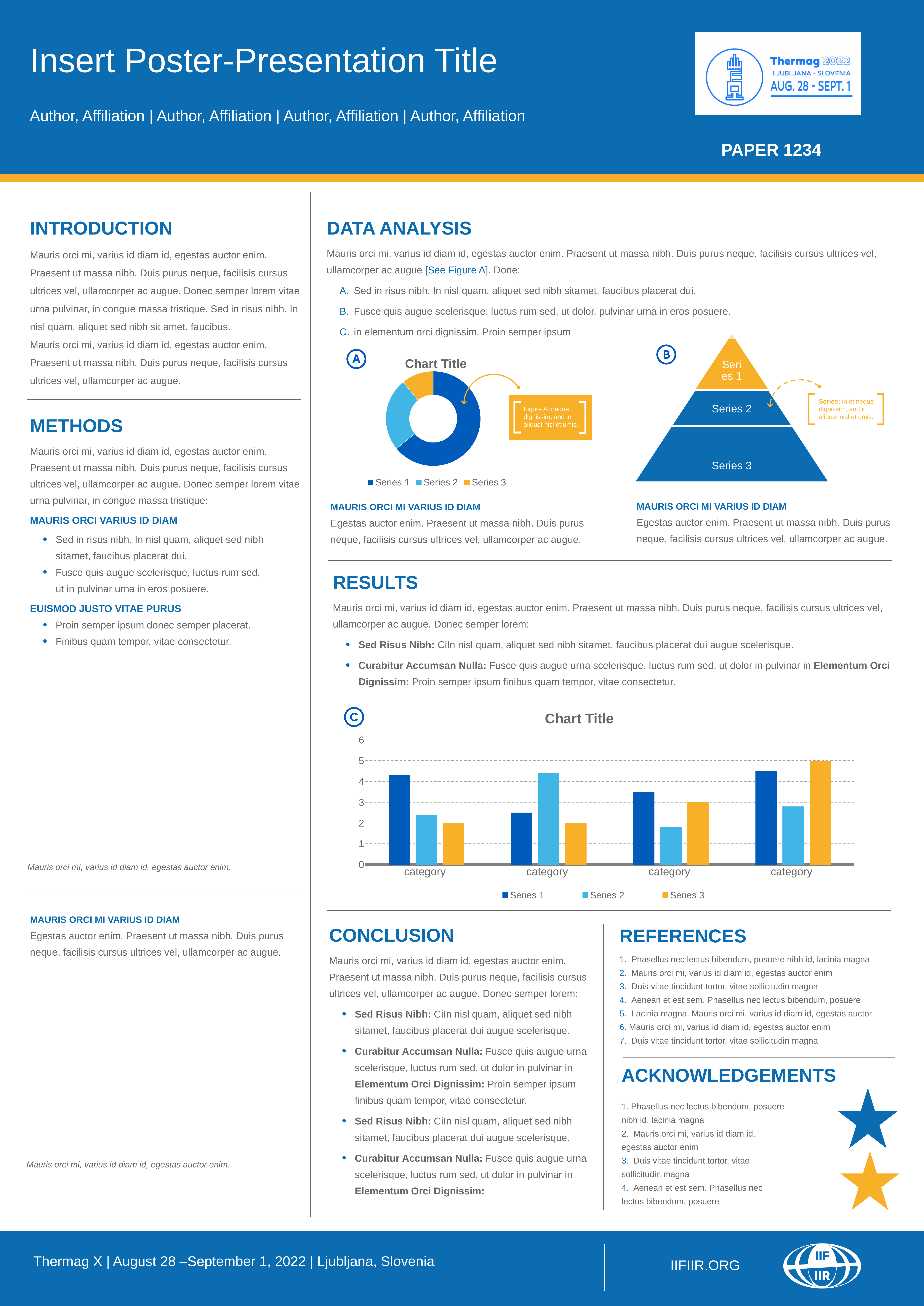
In Chart C, what is the value of Series 3 in the third category? 3 In Chart C, is the value of Series 2 in the third category greater or less than 2? less In Chart A, which series has the largest slice? Series 1 In Chart A, which series has the smallest slice? Series 3 In Chart C, what is the value of Series 3 in the fourth (rightmost) category? 5 What kind of chart is Chart C in the Results section? bar chart How many series does the legend of Chart A list? 3 In Chart C, in the fourth category, which is larger: Series 2 or Series 3? Series 3 How many categories are shown on the x axis of Chart C? 4 In Chart C, is the value of Series 1 in the first category greater or less than 3? greater How many series does the legend of Chart C list? 3 What kind of chart is Chart A in the Data Analysis section? doughnut chart